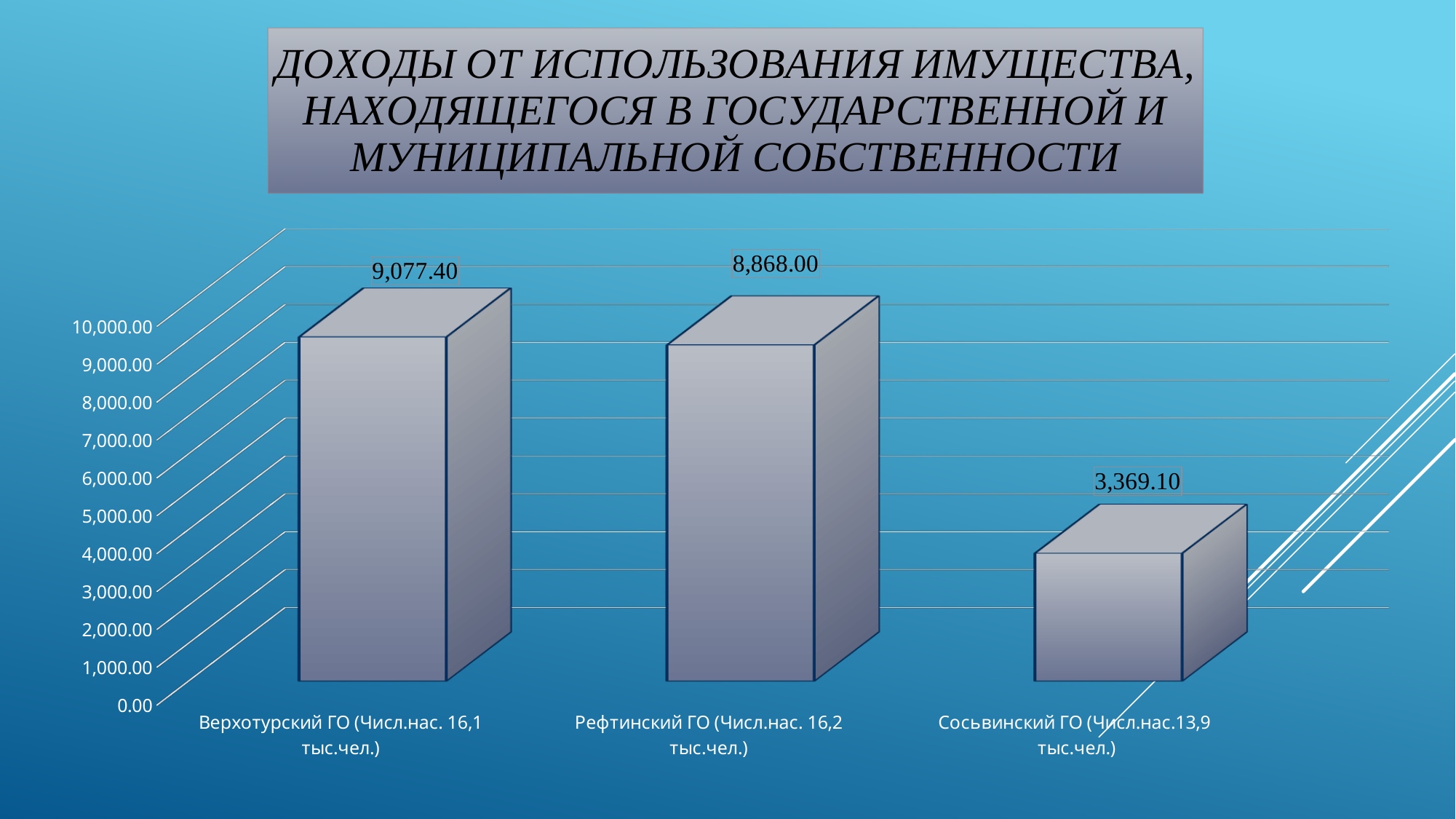
How many categories are shown in the chart? 3 What is the value for Сосьвинский ГО? 3,369.10 What is the value for Верхотурский ГО? 9,077.40 Which category has the highest value? Верхотурский ГО What kind of chart is shown on the slide? bar chart What is the value for Рефтинский ГО? 8,868.00 What is the difference between the values for Верхотурский ГО and Рефтинский ГО? 209.40 Which is larger, the value for Верхотурский ГО or the value for Рефтинский ГО? Верхотурский ГО Which category has the lowest value? Сосьвинский ГО Is the value for Сосьвинский ГО greater or less than 4,000.00? less What is the difference between the values for Рефтинский ГО and Сосьвинский ГО? 5,498.90 What is the population figure given in the label for Сосьвинский ГО? 13,9 тыс.чел.